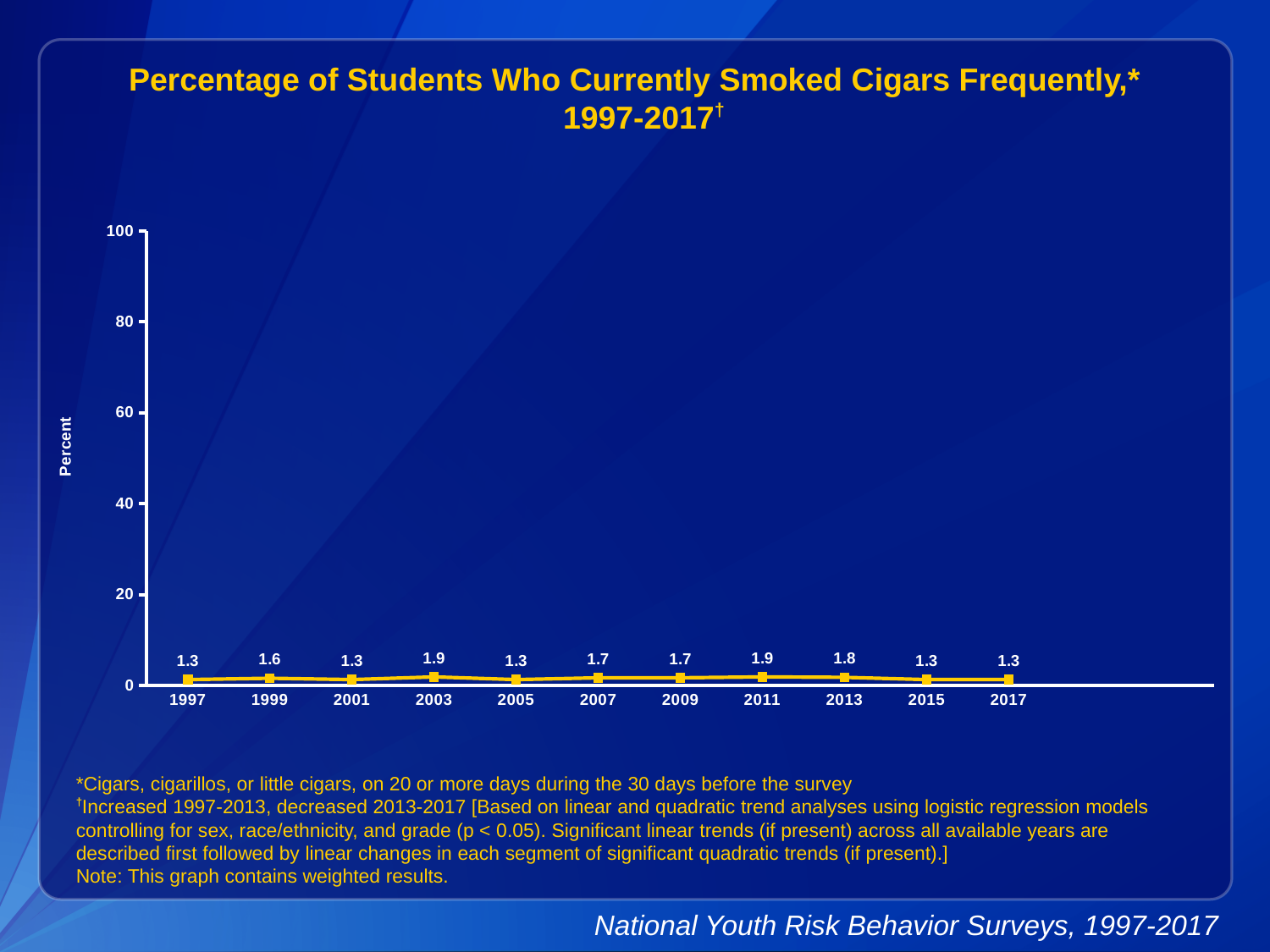
Between 2013 and 2017, do the values rise or fall? fall What is the value for 2017? 1.3 Which year has the larger value, 1999 or 2001? 1999 How many years are plotted on the x axis? 11 Is the value for 2011 greater or less than 20? less What is the value for 2003? 1.9 What is the value for 1997? 1.3 What is the highest value plotted on the chart? 1.9 What is the label on the y axis? Percent What is the difference between the values for 2003 and 1997? 0.6 What kind of chart is shown on the slide? line chart What is the value for 2013? 1.8